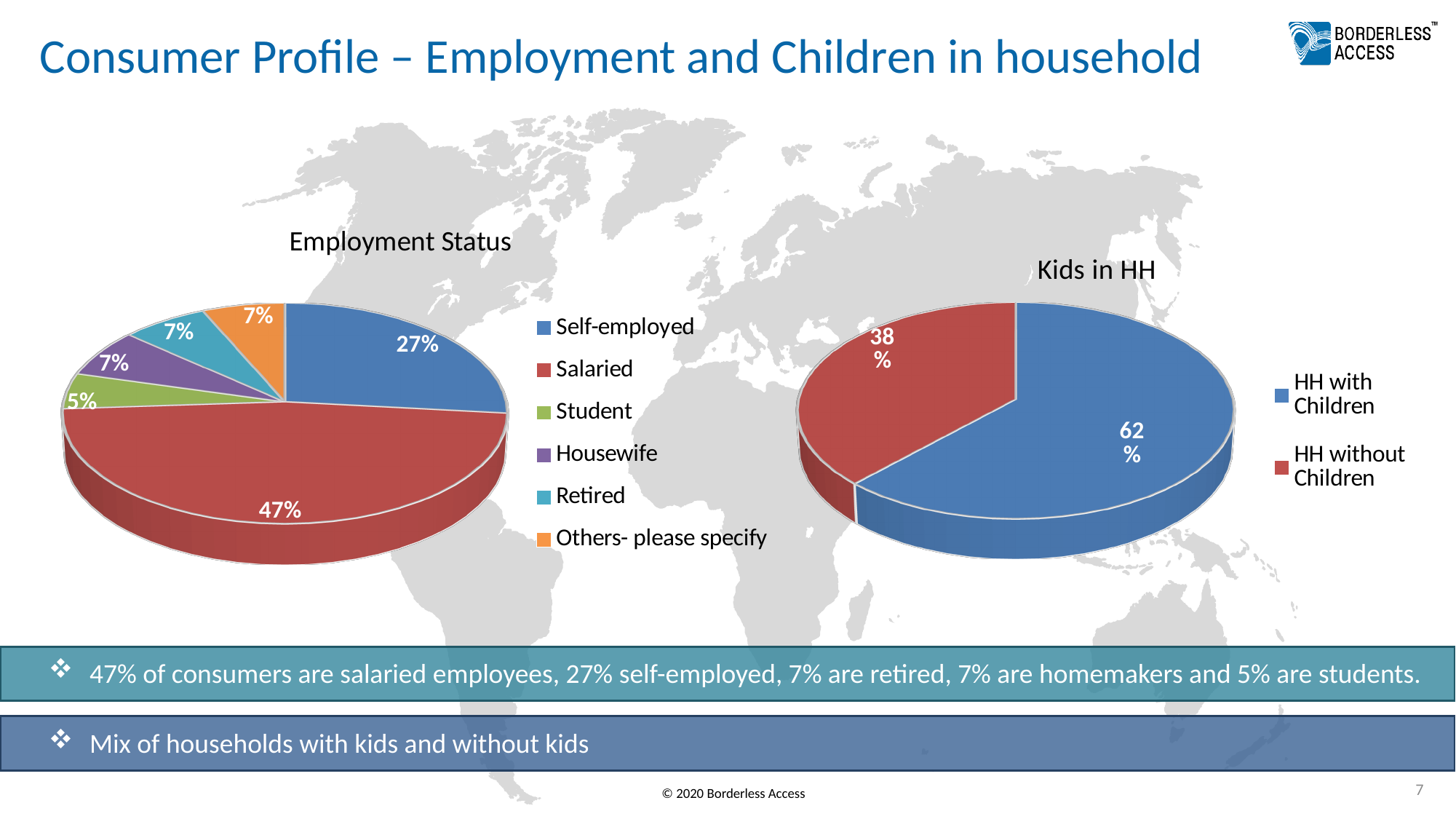
In the Kids in HH chart, what percentage of households are without children? 38% In the Employment Status chart, how many categories does the legend list? 6 In the Kids in HH chart, which is larger: HH with Children or HH without Children? HH with Children In the Employment Status chart, what percentage of consumers are Students? 5% In the Employment Status chart, what percentage of consumers are Salaried? 47% In the Employment Status chart, what percentage of consumers are Self-employed? 27% In the Kids in HH chart, what is the difference between HH with Children and HH without Children? 24% What type of chart is the Kids in HH chart? Pie chart In the Employment Status chart, what is the difference between the Salaried and Self-employed shares? 20% In the Employment Status chart, which category has the largest share? Salaried In the Employment Status chart, which category has the smallest share? Student In the Kids in HH chart, what percentage of households have children? 62%